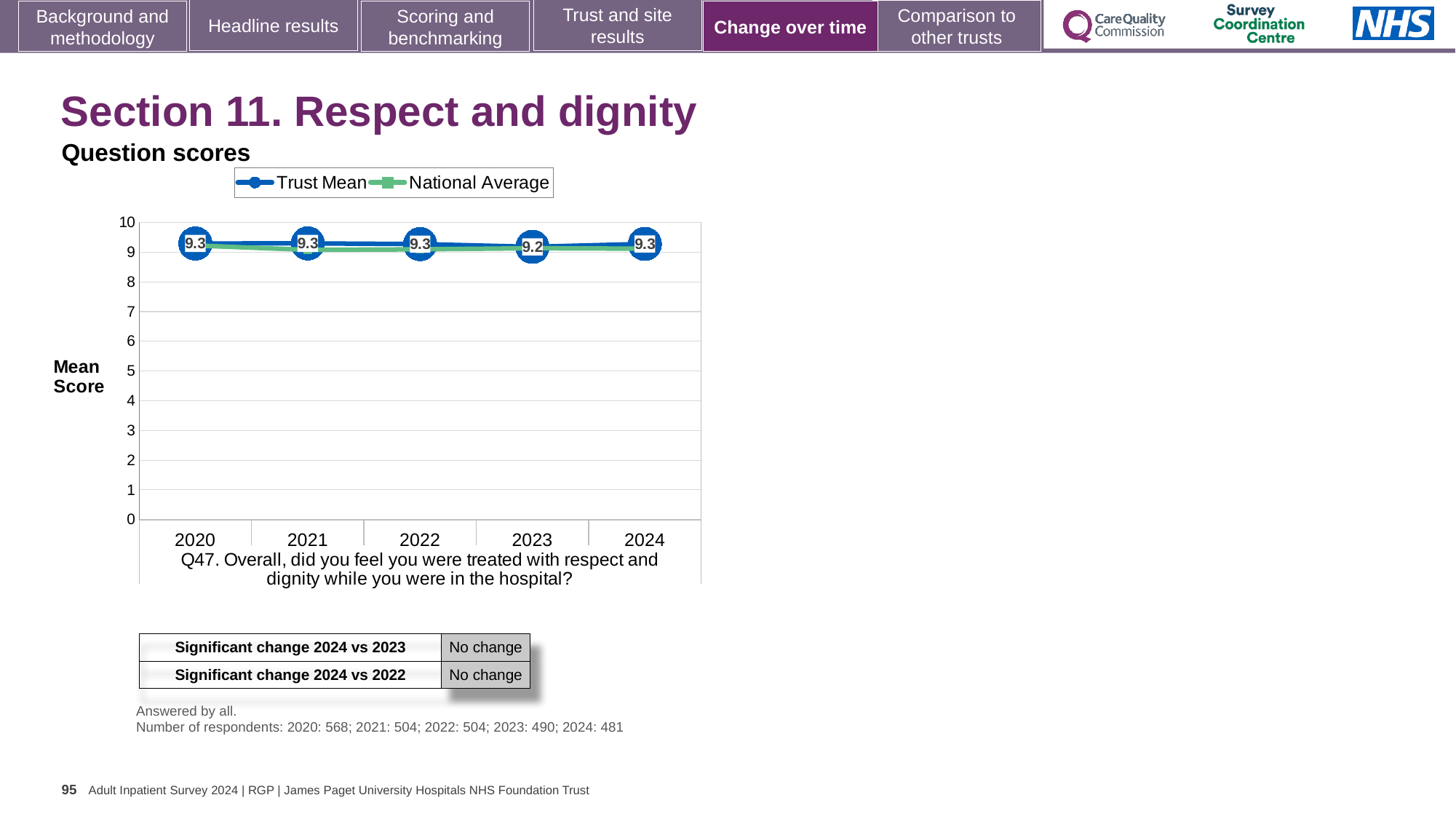
How many series does the legend list? 2 What are the two series named in the legend? Trust Mean and National Average In which year is the Trust Mean score lowest? 2023 Is the National Average value for 2024 greater or less than 8? greater What is the difference between the Trust Mean scores for 2024 and 2023? 0.1 What is the label on the y axis of the chart? Mean Score Is the Trust Mean score for 2022 larger than the Trust Mean score for 2023? Yes What is the Trust Mean score for 2020? 9.3 What is the Trust Mean score for 2024? 9.3 What is the Trust Mean score for 2023? 9.2 What kind of chart is shown on the slide? Line chart How many years are plotted on the x axis? 5